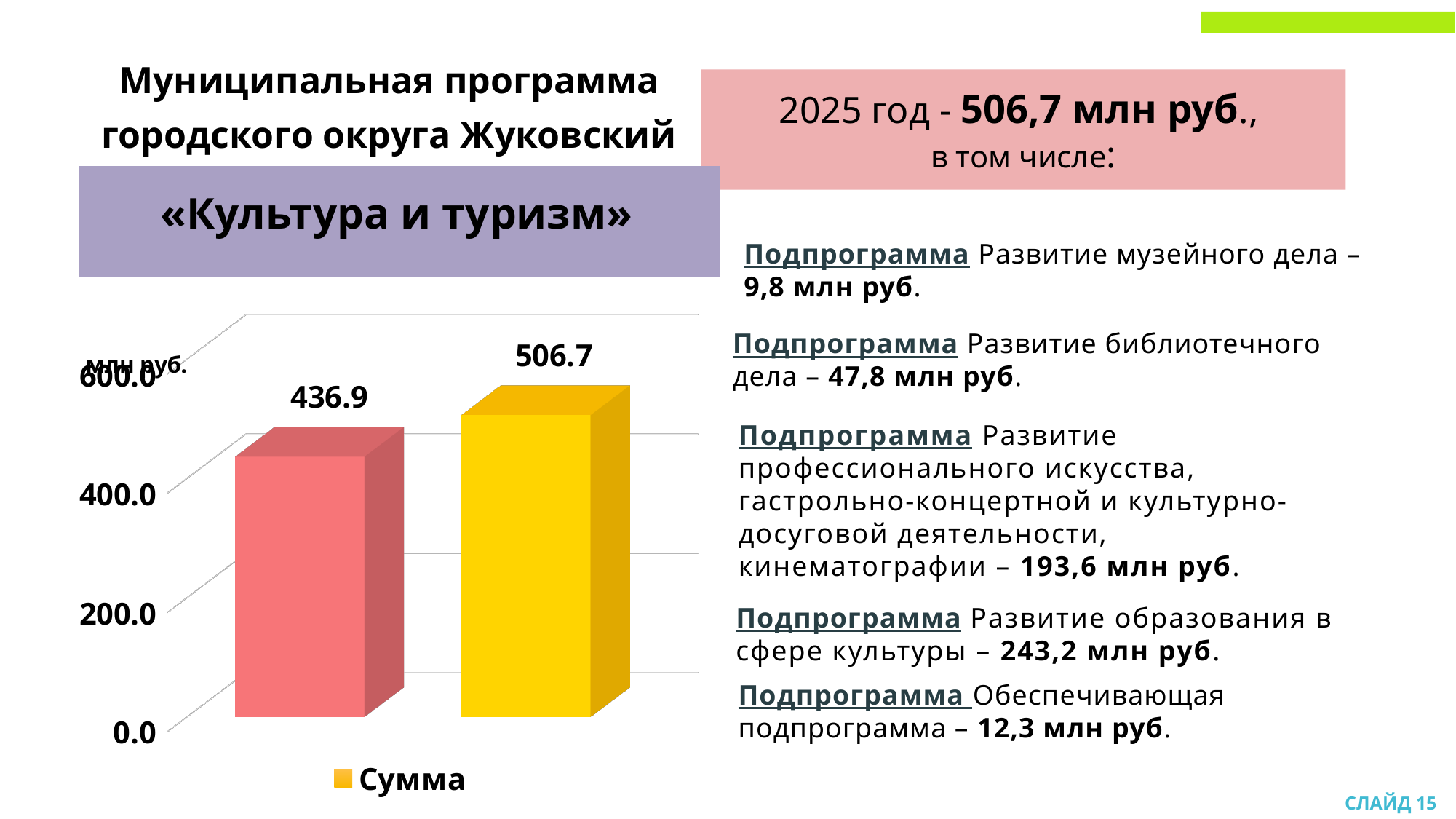
Which bar in the chart is the shortest, the left red one or the right yellow one? the left red bar How many bars are plotted in the chart? 2 How many series does the chart legend list? 1 What value is printed on the left (red) bar of the chart? 436.9 Is the value of the left (red) bar greater or less than 400? greater What value is printed on the right (yellow) bar of the chart? 506.7 Is the value of the left (red) bar larger or smaller than the value of the right (yellow) bar? smaller Is the value of the right (yellow) bar greater or less than 600? less What is the name of the series shown in the chart legend? Сумма Which bar in the chart is the tallest, the left red one or the right yellow one? the right yellow bar What kind of chart is shown on the slide? bar chart What is the difference between the values of the right (yellow) bar and the left (red) bar? 69.8